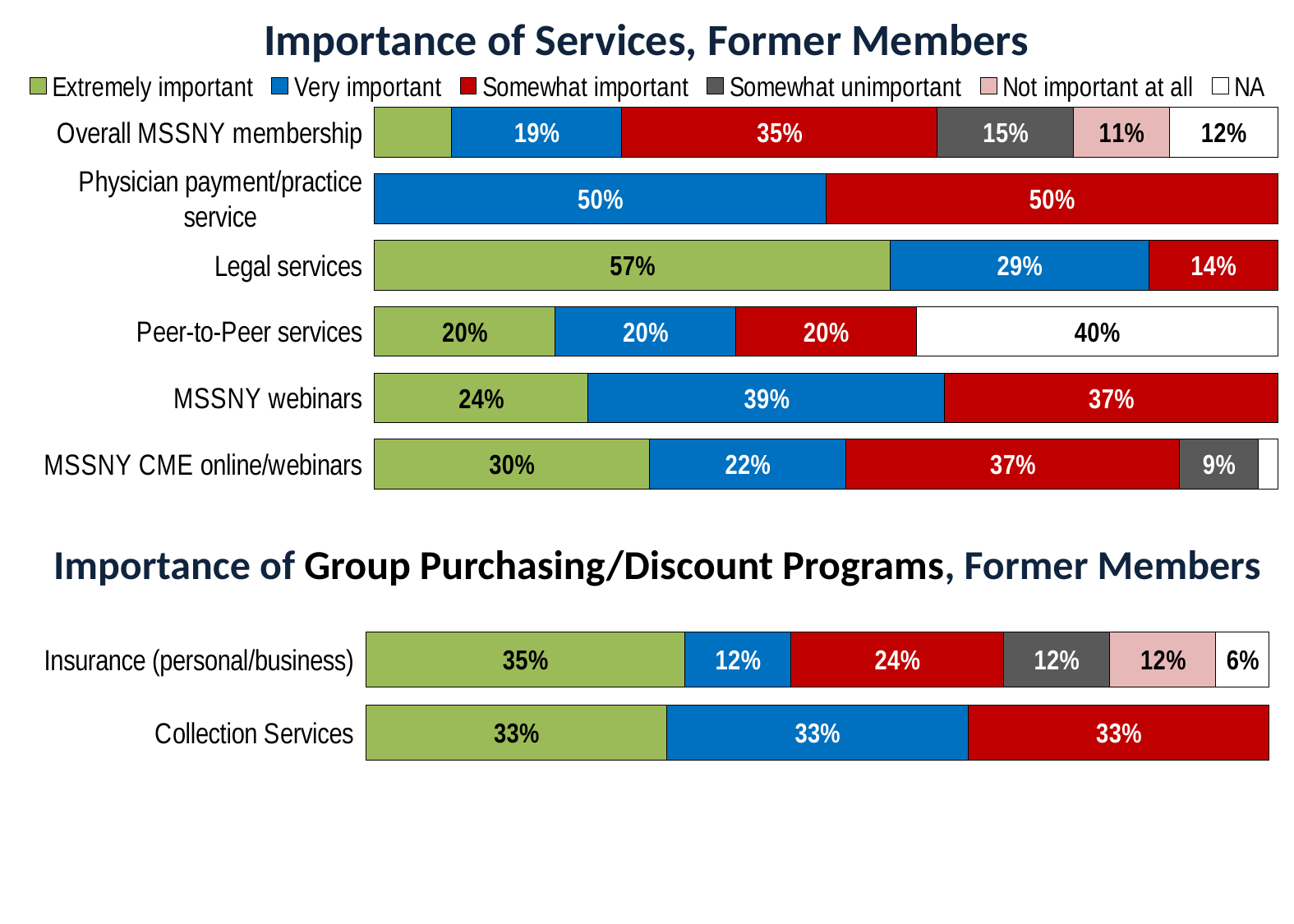
In the 'Importance of Services, Former Members' chart, which is larger: the Very important value for Physician payment/practice service or for Legal services? Physician payment/practice service In the 'Importance of Services, Former Members' chart, what percentage of former members rated Legal services as Extremely important? 57% In the 'Importance of Group Purchasing/Discount Programs, Former Members' chart, which legend entry is shown in green? Extremely important In the 'Importance of Services, Former Members' chart, what is the Somewhat important value for Overall MSSNY membership? 35% In the 'Importance of Services, Former Members' chart, what is the difference between the Very important values for MSSNY webinars and MSSNY CME online/webinars? 17% In the 'Importance of Services, Former Members' chart, which service has the highest Extremely important percentage? Legal services In the 'Importance of Group Purchasing/Discount Programs, Former Members' chart, what is the NA value for Insurance (personal/business)? 6% In the 'Importance of Group Purchasing/Discount Programs, Former Members' chart, what is the Extremely important value for Insurance (personal/business)? 35% In the 'Importance of Services, Former Members' chart, what is the NA value for Peer-to-Peer services? 40% How many services are listed in the 'Importance of Services, Former Members' chart? 6 What kind of chart is the 'Importance of Services, Former Members' chart? Stacked bar chart How many series does the legend of the 'Importance of Services, Former Members' chart list? 6